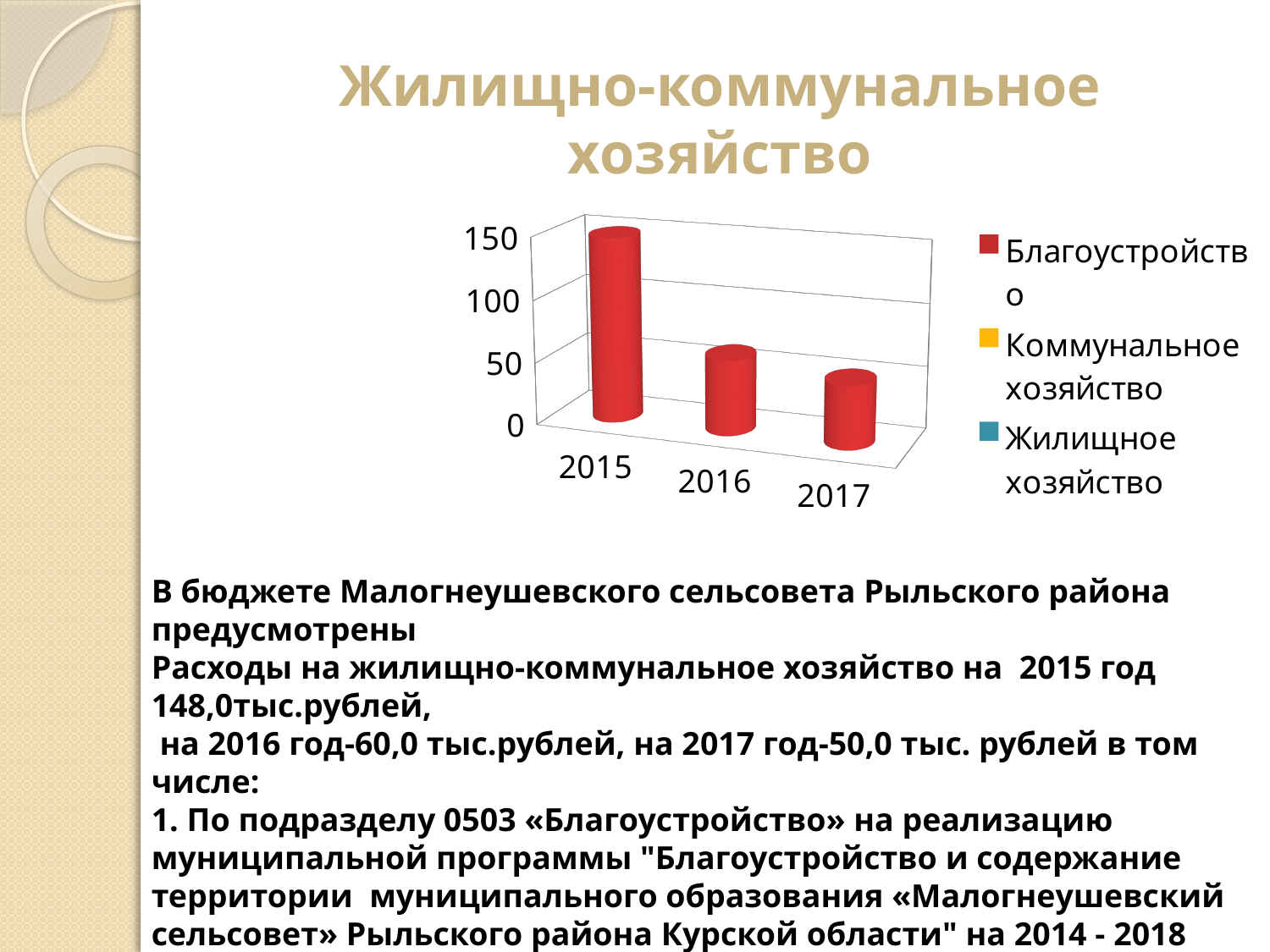
Is the bar for 2017 greater or less than 100? less What kind of chart is shown on the slide? bar chart Is the bar for 2016 greater or less than 100? less Which year has the lowest bar in the chart? 2017 How many years are shown on the x axis of the chart? 3 Is the bar for 2015 greater or less than 100? greater Which legend entry is shown in red? Благоустройство How many series does the chart legend list? 3 Do the bar values rise or fall from 2015 to 2017? fall What is the title of the slide containing the chart? Жилищно-коммунальное хозяйство Which year has the highest bar in the chart? 2015 Which bar is taller, 2015 or 2016? 2015